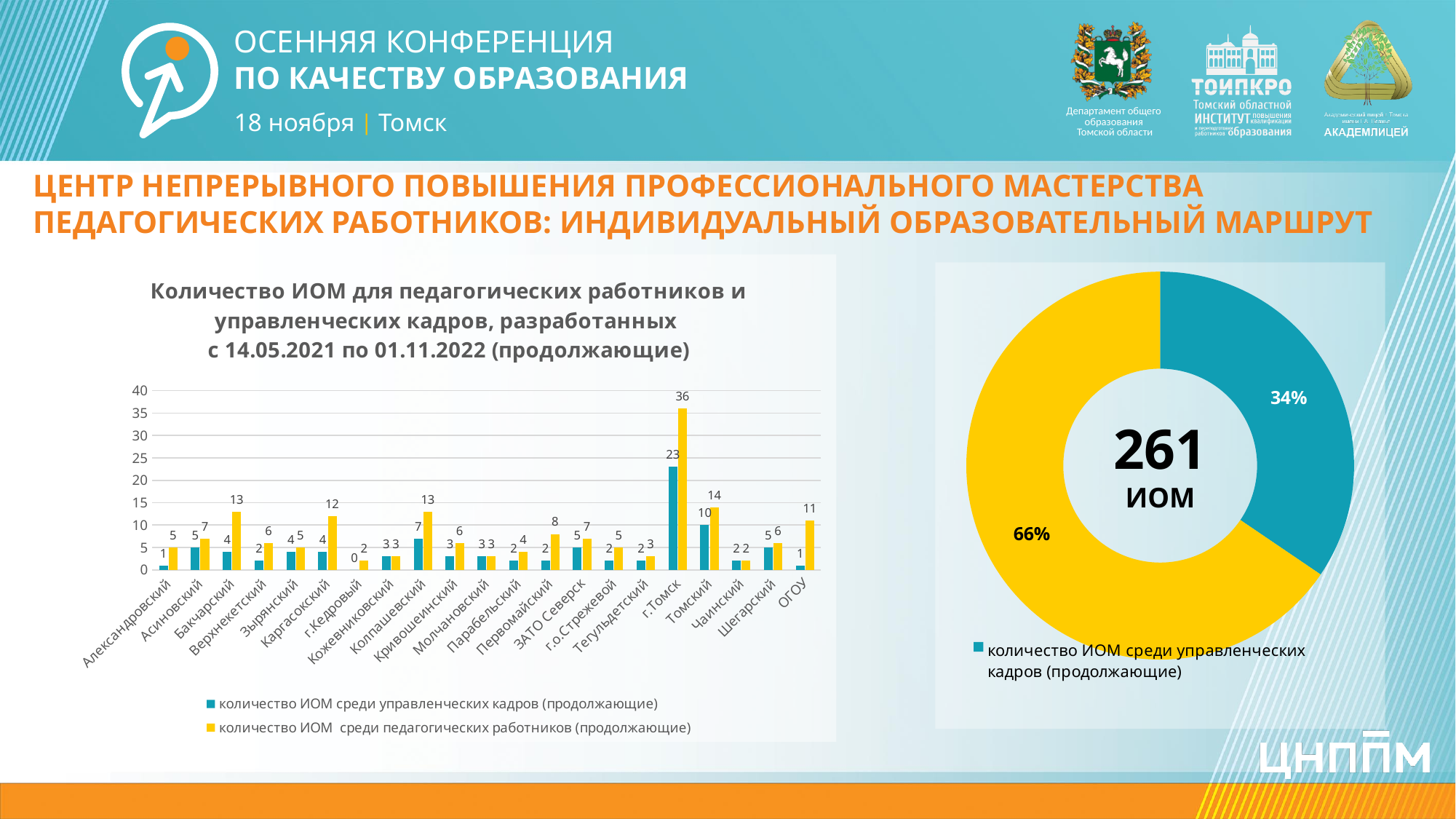
On the bar chart, which category has the highest value in the series 'количество ИОМ среди управленческих кадров (продолжающие)'? г.Томск On the bar chart, what is the difference between the two series values for г.Томск? 13 What number is shown in the centre of the donut chart on the right? 261 What kind of chart is the chart on the left of the slide? bar chart On the bar chart, what is the value for г.Томск in the series 'количество ИОМ среди педагогических работников (продолжающие)'? 36 On the bar chart, what is the value for Томский in the series 'количество ИОМ среди управленческих кадров (продолжающие)'? 10 On the donut chart on the right, what share is shown for 'количество ИОМ среди управленческих кадров (продолжающие)'? 34% On the bar chart, which is larger for Бакчарский: the value for управленческих кадров or the value for педагогических работников? педагогических работников How many categories are shown on the x axis of the bar chart? 21 On the bar chart, which category has the lowest value in the series 'количество ИОМ среди управленческих кадров (продолжающие)'? г.Кедровый How many series does the legend of the bar chart list? 2 On the bar chart, what is the value for ОГОУ in the series 'количество ИОМ среди педагогических работников (продолжающие)'? 11